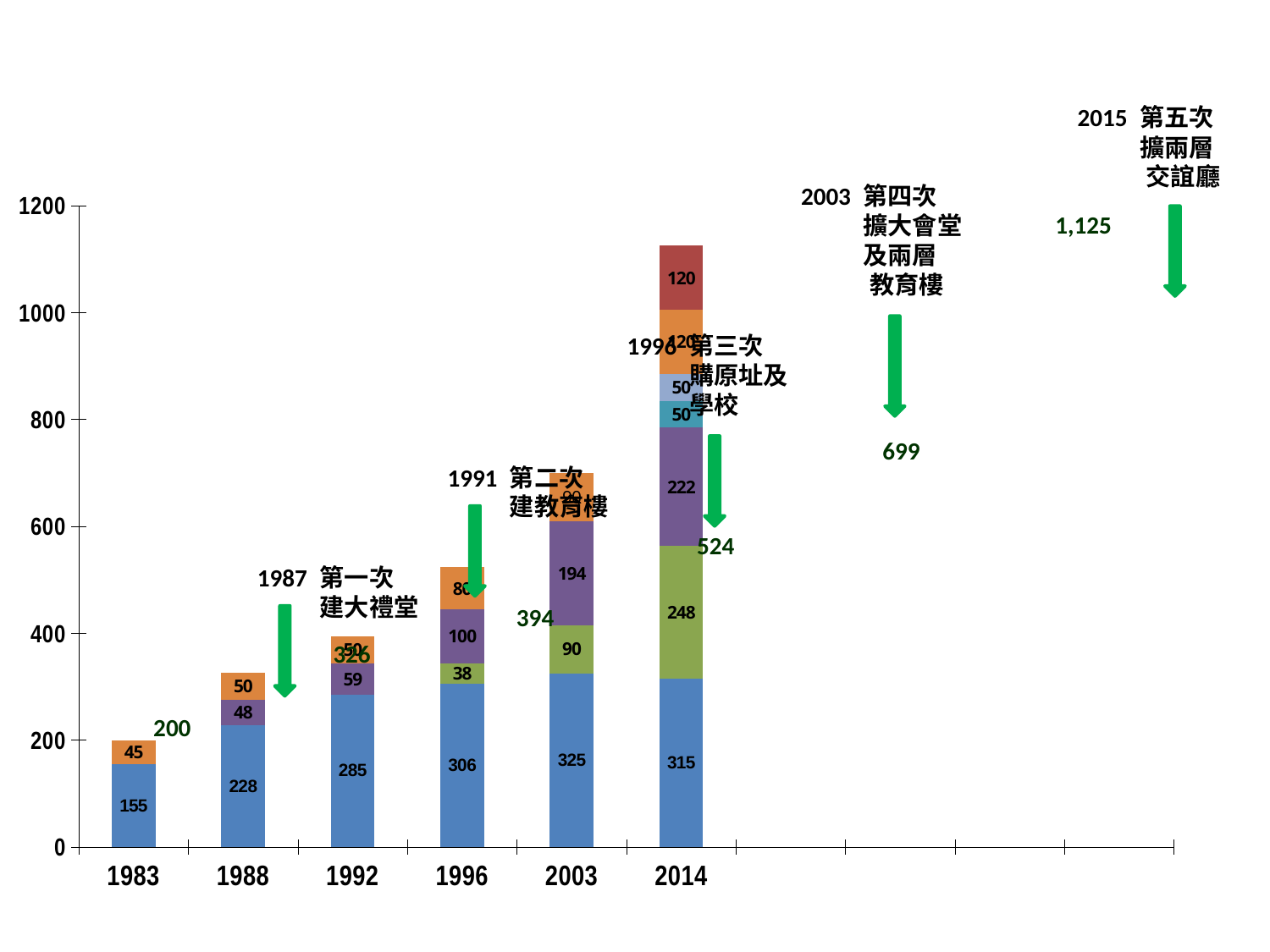
What is the value of the bottom (blue) segment of the 2014 bar? 315 What is the total of the 1988 stacked bar? 326 How many years (bars) are shown on the x axis? 6 What is the difference between the bottom (blue) segments of the 1988 and 1983 bars? 73 What is the value of the purple segment of the 1988 bar? 48 Do the bar totals rise or fall from 1983 to 2014? rise Which year has the shortest bar? 1983 What is the value of the bottom (blue) segment of the 1983 bar? 155 What is the value of the green segment of the 2014 bar? 248 What kind of chart is shown on the slide? stacked bar chart Which year has the tallest bar? 2014 What is the total of the 1983 stacked bar? 200